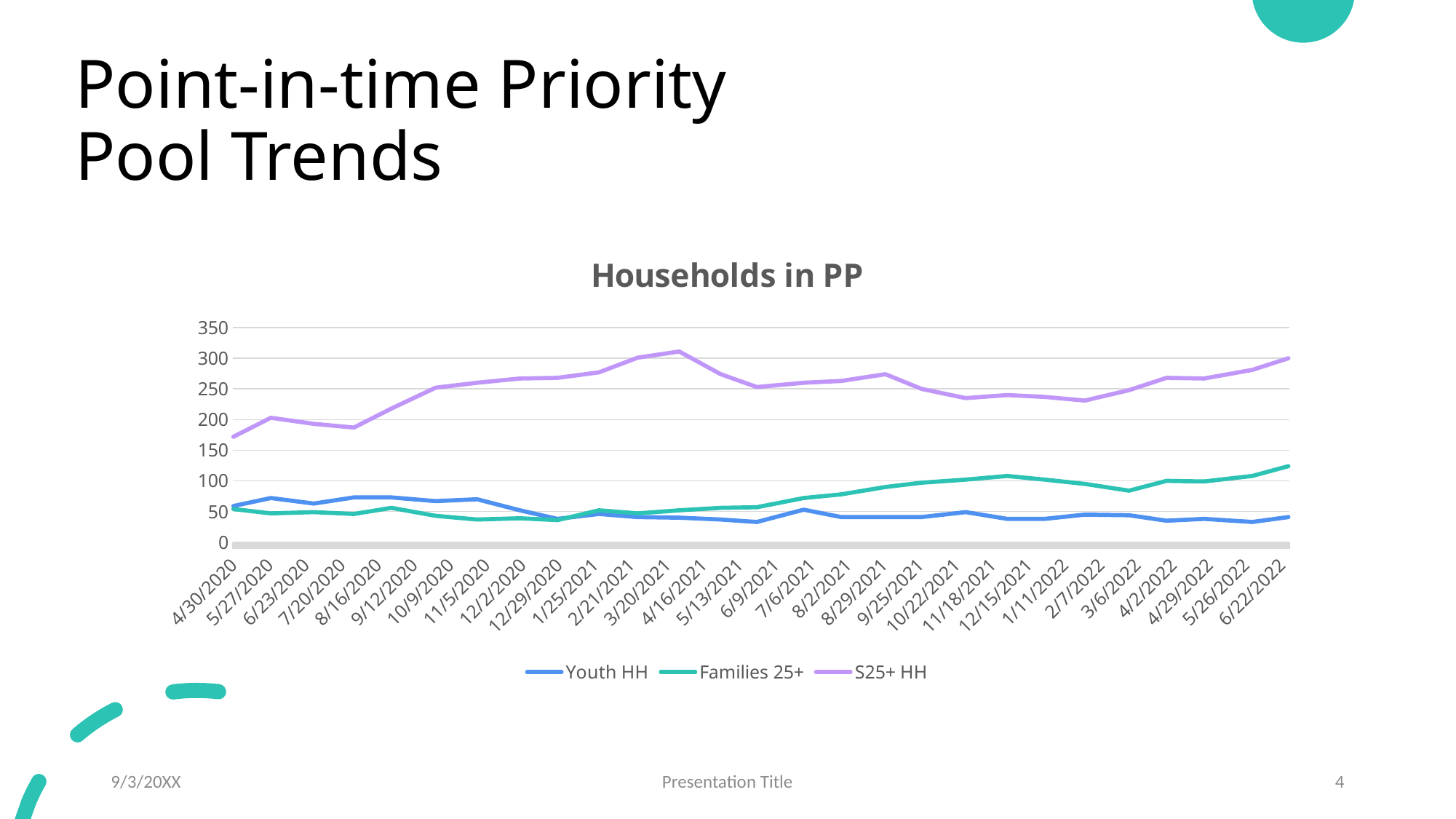
On which date is the Families 25+ series at its highest? 6/22/2022 Is the value for Families 25+ on 6/22/2022 greater or less than 100? greater How many dates are shown along the x axis? 30 Is the value for S25+ HH on 4/30/2020 greater or less than 200? less How many series does the legend list? 3 Which series has the larger value on 4/30/2020, S25+ HH or Youth HH? S25+ HH Is the value for S25+ HH on 2/7/2022 greater or less than 250? less What is the title of the chart? Households in PP On which date is the S25+ HH series at its lowest? 4/30/2020 What kind of chart is shown on the slide? line chart